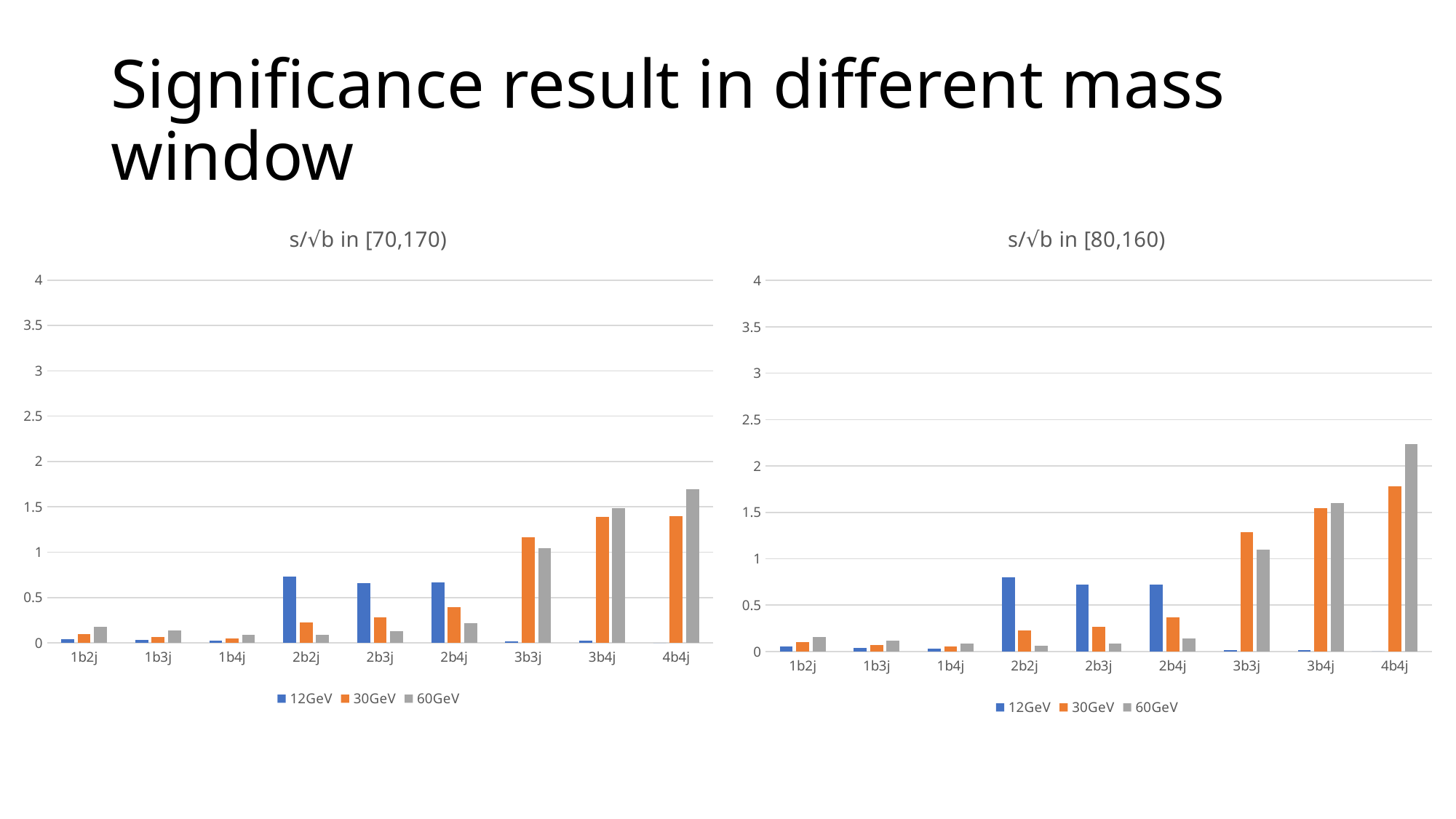
In the right chart "s/√b in [80,160)", which category has the highest 30GeV value? 4b4j In the right chart "s/√b in [80,160)", is the 60GeV value for 4b4j greater or less than 2? greater In the right chart "s/√b in [80,160)", which category has the highest 60GeV value? 4b4j What kind of chart is the left chart, titled "s/√b in [70,170)"? bar chart In the left chart "s/√b in [70,170)", is the 12GeV value for 2b2j greater or less than 0.5? greater In the right chart "s/√b in [80,160)", how many series does the legend list? 3 In the left chart "s/√b in [70,170)", how many categories are shown on the x axis? 9 In the left chart "s/√b in [70,170)", which category has the highest 60GeV value? 4b4j In the right chart "s/√b in [80,160)", is the 60GeV value for 1b2j greater or less than 0.5? less In the left chart "s/√b in [70,170)", for category 2b2j, which is larger: the 12GeV value or the 30GeV value? 12GeV In the right chart "s/√b in [80,160)", for category 3b3j, which is larger: the 30GeV value or the 60GeV value? 30GeV